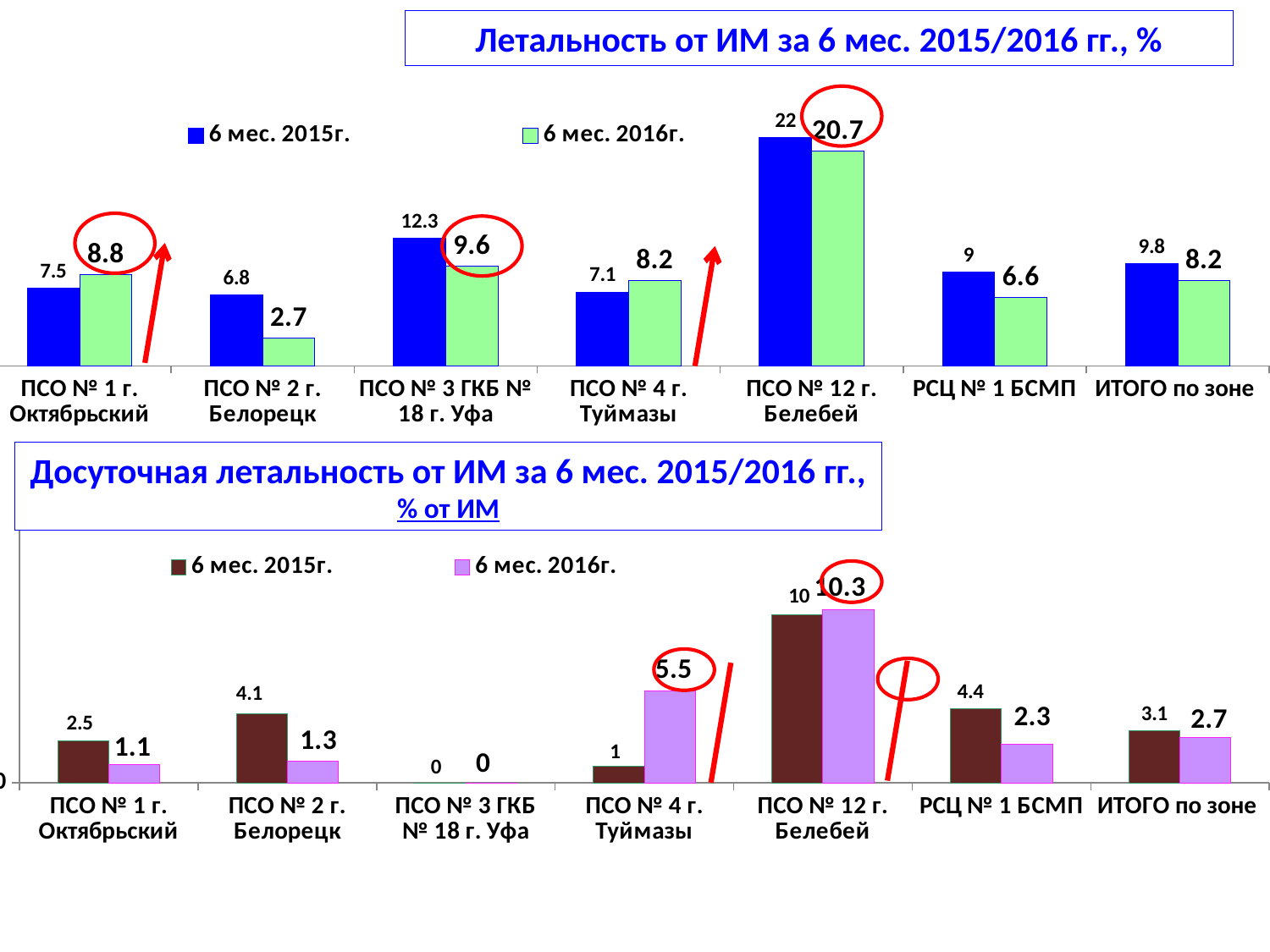
In the bottom chart 'Досуточная летальность от ИМ за 6 мес. 2015/2016 гг., % от ИМ', what is the value for ПСО № 4 г. Туймазы for 6 мес. 2016г.? 5.5 In the bottom chart 'Досуточная летальность от ИМ за 6 мес. 2015/2016 гг., % от ИМ', what is the difference between the 6 мес. 2015г. and 6 мес. 2016г. values for ПСО № 2 г. Белорецк? 2.8 In the bottom chart 'Досуточная летальность от ИМ за 6 мес. 2015/2016 гг., % от ИМ', what is the value for РСЦ № 1 БСМП for 6 мес. 2015г.? 4.4 How many categories are shown on the x axis of the bottom chart 'Досуточная летальность от ИМ за 6 мес. 2015/2016 гг., % от ИМ'? 7 In the top chart 'Летальность от ИМ за 6 мес. 2015/2016 гг., %', which category has the lowest value for 6 мес. 2015г.? ПСО № 2 г. Белорецк In the top chart 'Летальность от ИМ за 6 мес. 2015/2016 гг., %', what is the difference between the 6 мес. 2015г. and 6 мес. 2016г. values for ПСО № 3 ГКБ № 18 г. Уфа? 2.7 How many series does the legend of the top chart 'Летальность от ИМ за 6 мес. 2015/2016 гг., %' list? 2 In the top chart 'Летальность от ИМ за 6 мес. 2015/2016 гг., %', which category has the highest value for 6 мес. 2016г.? ПСО № 12 г. Белебей In the top chart 'Летальность от ИМ за 6 мес. 2015/2016 гг., %', which is larger for ИТОГО по зоне: 6 мес. 2015г. or 6 мес. 2016г.? 6 мес. 2015г. In the bottom chart 'Досуточная летальность от ИМ за 6 мес. 2015/2016 гг., % от ИМ', which category has the highest value for 6 мес. 2016г.? ПСО № 12 г. Белебей In the top chart 'Летальность от ИМ за 6 мес. 2015/2016 гг., %', what is the value for ПСО № 12 г. Белебей for 6 мес. 2015г.? 22 In the top chart 'Летальность от ИМ за 6 мес. 2015/2016 гг., %', what is the value for ПСО № 2 г. Белорецк for 6 мес. 2016г.? 2.7